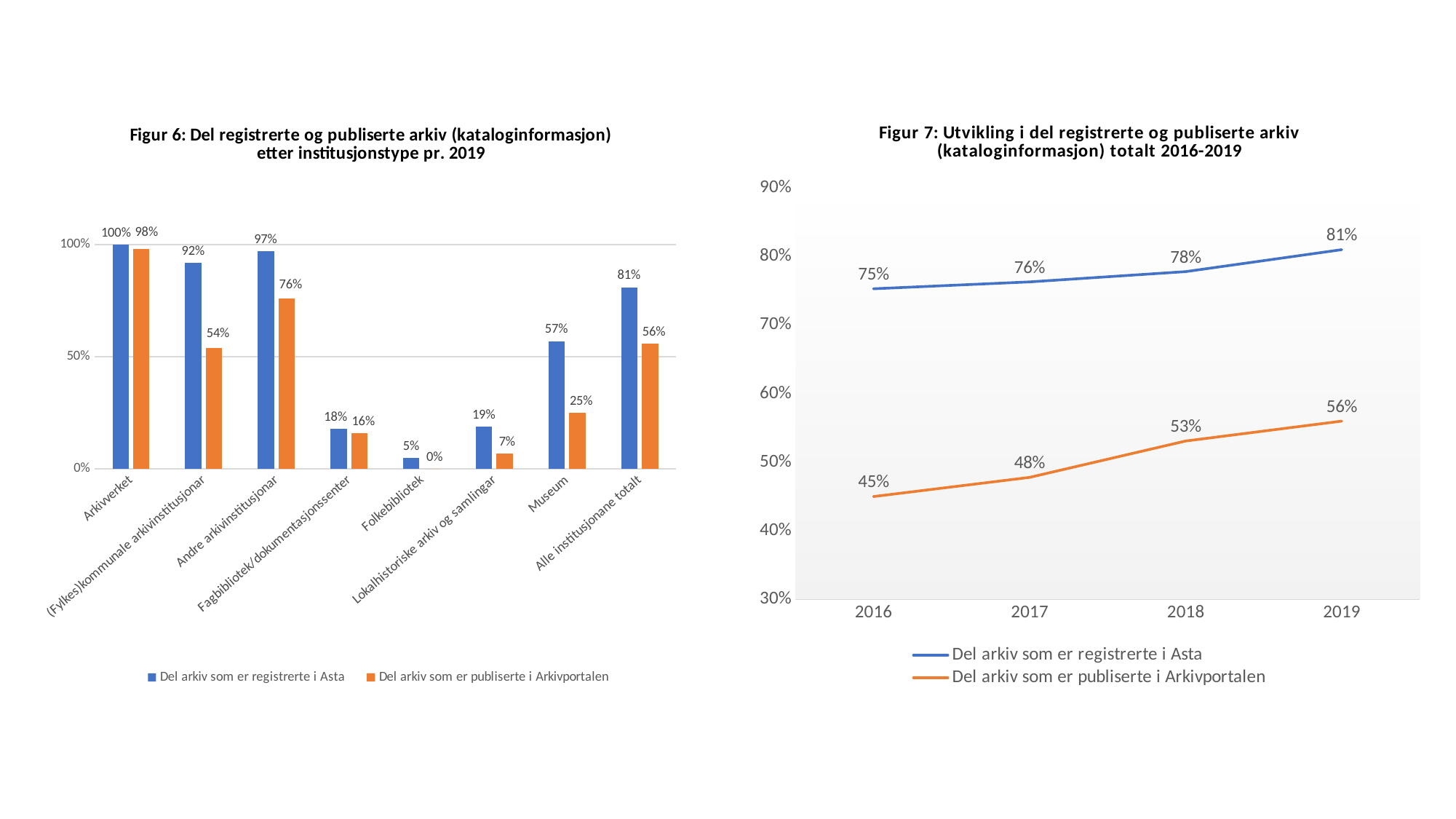
In Figur 6, what kind of chart is shown? Bar chart In Figur 7, how many series does the legend list? 2 In Figur 6, what is the value for Museum in the series 'Del arkiv som er registrerte i Asta'? 57% In Figur 6, which category has the highest value in the series 'Del arkiv som er registrerte i Asta'? Arkivverket In Figur 7, what is the value for 'Del arkiv som er registrerte i Asta' in 2016? 75% In Figur 6, what is the value for Andre arkivinstitusjonar in the series 'Del arkiv som er publiserte i Arkivportalen'? 76% In Figur 7, what is the difference between the two series in 2019? 25% In Figur 7, does the series 'Del arkiv som er publiserte i Arkivportalen' rise or fall from 2016 to 2019? Rise In Figur 7, what is the value for 'Del arkiv som er publiserte i Arkivportalen' in 2018? 53% In Figur 6, which category has the lowest value in the series 'Del arkiv som er registrerte i Asta'? Folkebibliotek In Figur 6, what is the difference between the two series for (Fylkes)kommunale arkivinstitusjonar? 38% In Figur 6, how many categories are shown on the x axis? 8